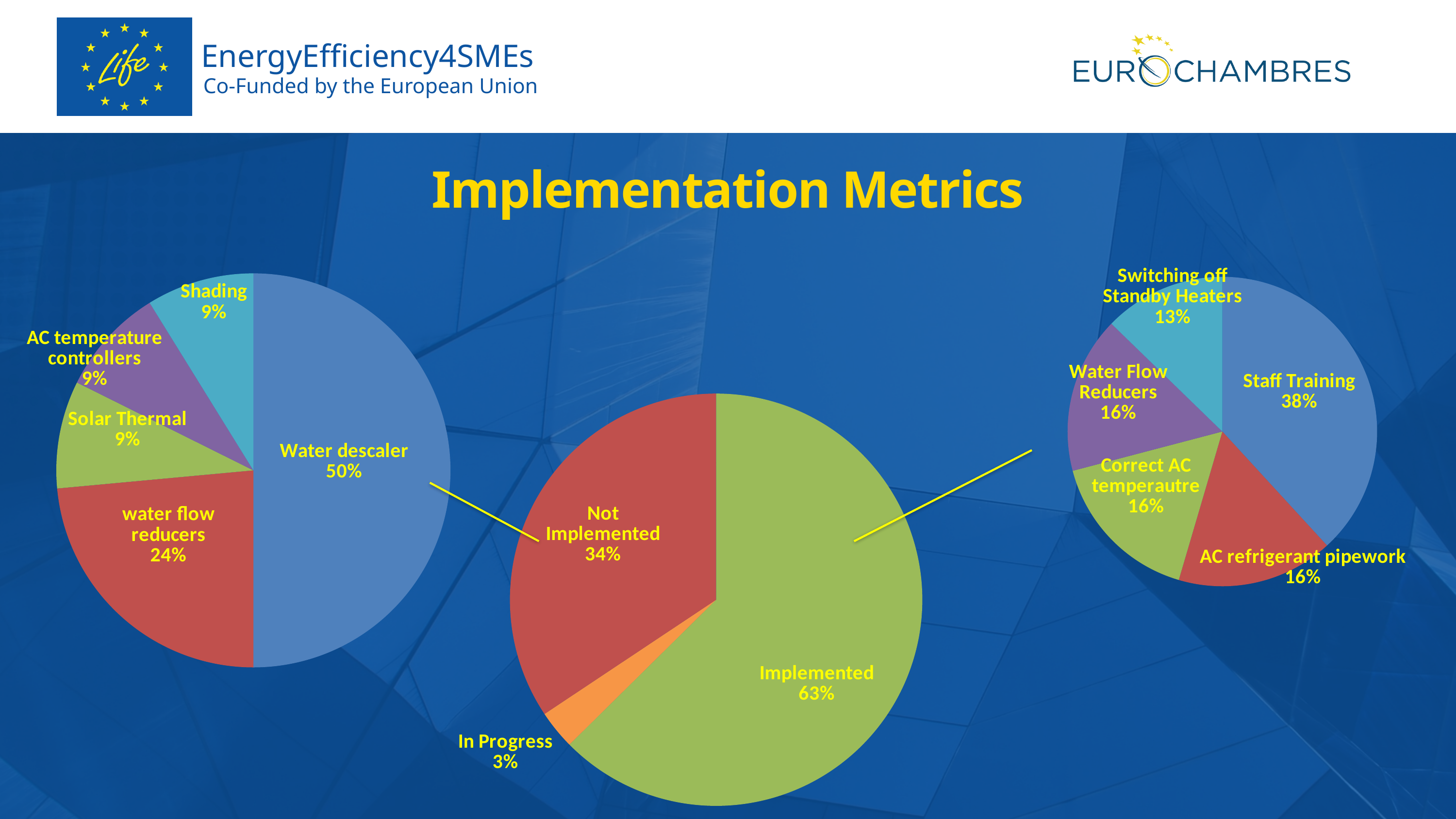
In the middle pie chart, what share is labelled In Progress? 3% In the right pie chart, which category has the smallest slice? Switching off Standby Heaters What type of chart is used for the three charts on the slide? Pie chart In the left pie chart, what share is labelled water flow reducers? 24% In the right pie chart, what share is labelled Staff Training? 38% In the left pie chart, what share is labelled Water descaler? 50% In the right pie chart, what is the difference between Staff Training and Water Flow Reducers? 22% How many slices does the left pie chart have? 5 In the middle pie chart, what share is labelled Implemented? 63% In the middle pie chart, which category has the largest slice? Implemented In the middle pie chart, what is the difference between the Implemented and Not Implemented shares? 29% In the left pie chart, which is larger, Water descaler or water flow reducers? Water descaler